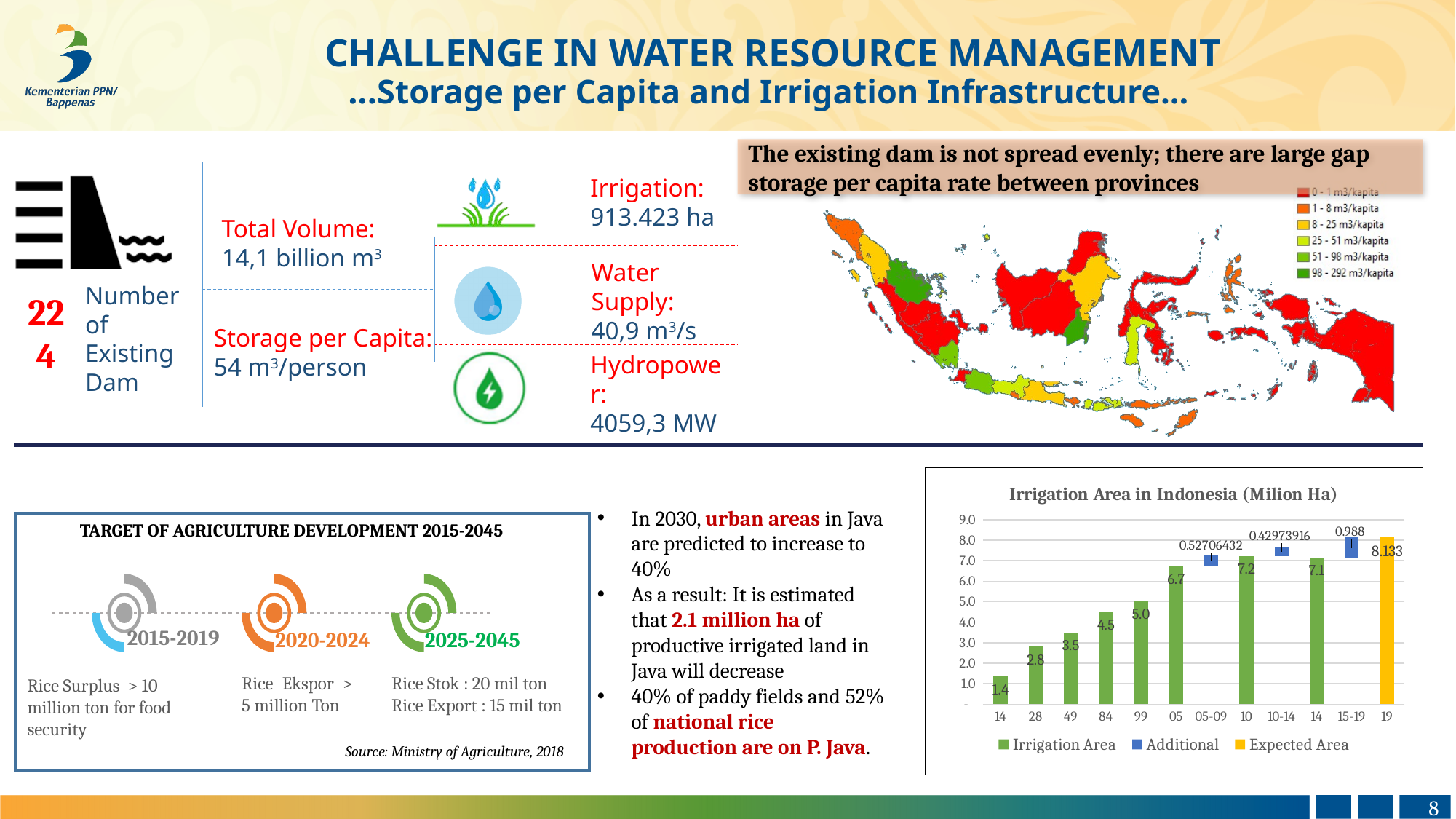
In the 'Irrigation Area in Indonesia' chart, what is the difference between the Irrigation Area values for categories 10 and 05? 0.5 In the 'Irrigation Area in Indonesia' chart, which category has the tallest bar? 19 What kind of chart is the 'Irrigation Area in Indonesia (Milion Ha)' chart? bar chart In the 'Irrigation Area in Indonesia' chart, which has the larger Irrigation Area value: category 84 or category 49? 84 In the 'Irrigation Area in Indonesia' chart, what is the Irrigation Area value for the category 99? 5.0 How many categories are shown on the x axis of the 'Irrigation Area in Indonesia' chart? 12 In the 'Irrigation Area in Indonesia' chart, do the Irrigation Area values rise or fall from the first category to the category 05? rise In the 'Irrigation Area in Indonesia' chart, what is the Additional value for the category 15-19? 0.988 In the 'Irrigation Area in Indonesia' chart, what is the Irrigation Area value for the category 05? 6.7 In the 'Irrigation Area in Indonesia' chart, what is the Expected Area value for the category 19? 8.133 In the 'Irrigation Area in Indonesia' chart, what is the Irrigation Area value for the category 28? 2.8 How many series does the legend of the 'Irrigation Area in Indonesia' chart list? 3